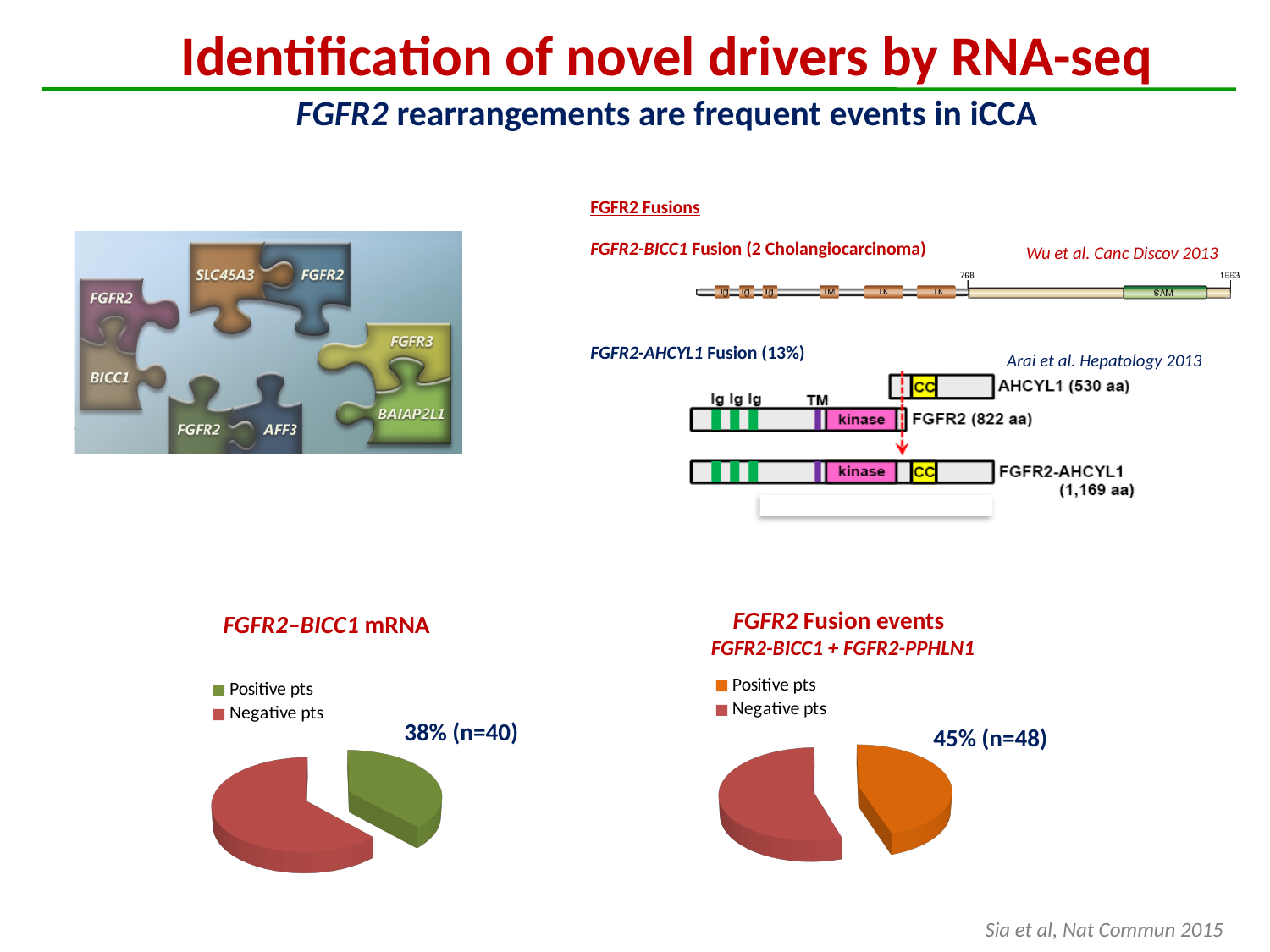
What is the difference in percentage points between the Positive pts share in the 'FGFR2 Fusion events' chart and the 'FGFR2–BICC1 mRNA' chart? 7 percentage points What kind of chart is the 'FGFR2–BICC1 mRNA' chart? Pie chart In the 'FGFR2–BICC1 mRNA' pie chart, which slice is larger, Positive pts or Negative pts? Negative pts In the 'FGFR2–BICC1 mRNA' pie chart, what share of patients are Positive pts? 38% In the 'FGFR2 Fusion events' pie chart, what colour represents Positive pts? Orange What is the subtitle printed under the 'FGFR2 Fusion events' chart title? FGFR2-BICC1 + FGFR2-PPHLN1 Which chart shows a larger share of Positive pts, 'FGFR2–BICC1 mRNA' or 'FGFR2 Fusion events'? FGFR2 Fusion events How many categories does the legend of the 'FGFR2–BICC1 mRNA' pie chart list? 2 In the 'FGFR2 Fusion events' pie chart, which slice is larger, Positive pts or Negative pts? Negative pts In the 'FGFR2 Fusion events' pie chart, what share of patients are Positive pts? 45%